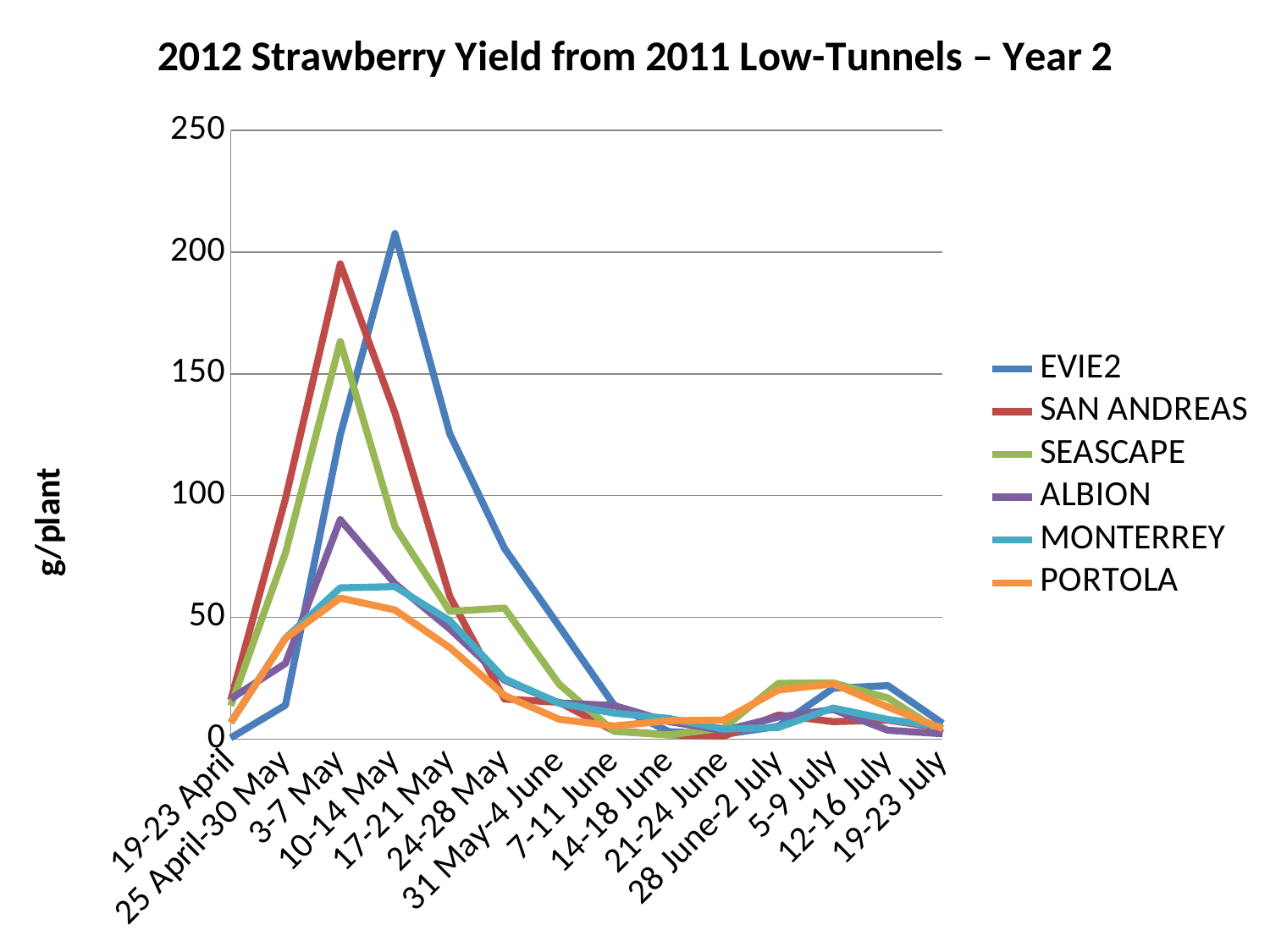
What kind of chart is shown on the slide? Line chart Which series reaches the highest value anywhere on the chart? EVIE2 Does the EVIE2 line rise or fall from 10-14 May to 14-18 June? Fall Is the value for SEASCAPE in 3-7 May greater or less than 150? greater In 3-7 May, which is larger: the value for SAN ANDREAS or the value for EVIE2? SAN ANDREAS In which period does EVIE2 reach its highest value? 10-14 May How many date periods are shown along the x axis? 14 Is the value for ALBION in 3-7 May greater or less than 100? less In which period does SAN ANDREAS reach its highest value? 3-7 May How many series does the legend list? 6 What is the label on the y axis? g/plant Is the value for EVIE2 in 10-14 May greater or less than 200? greater